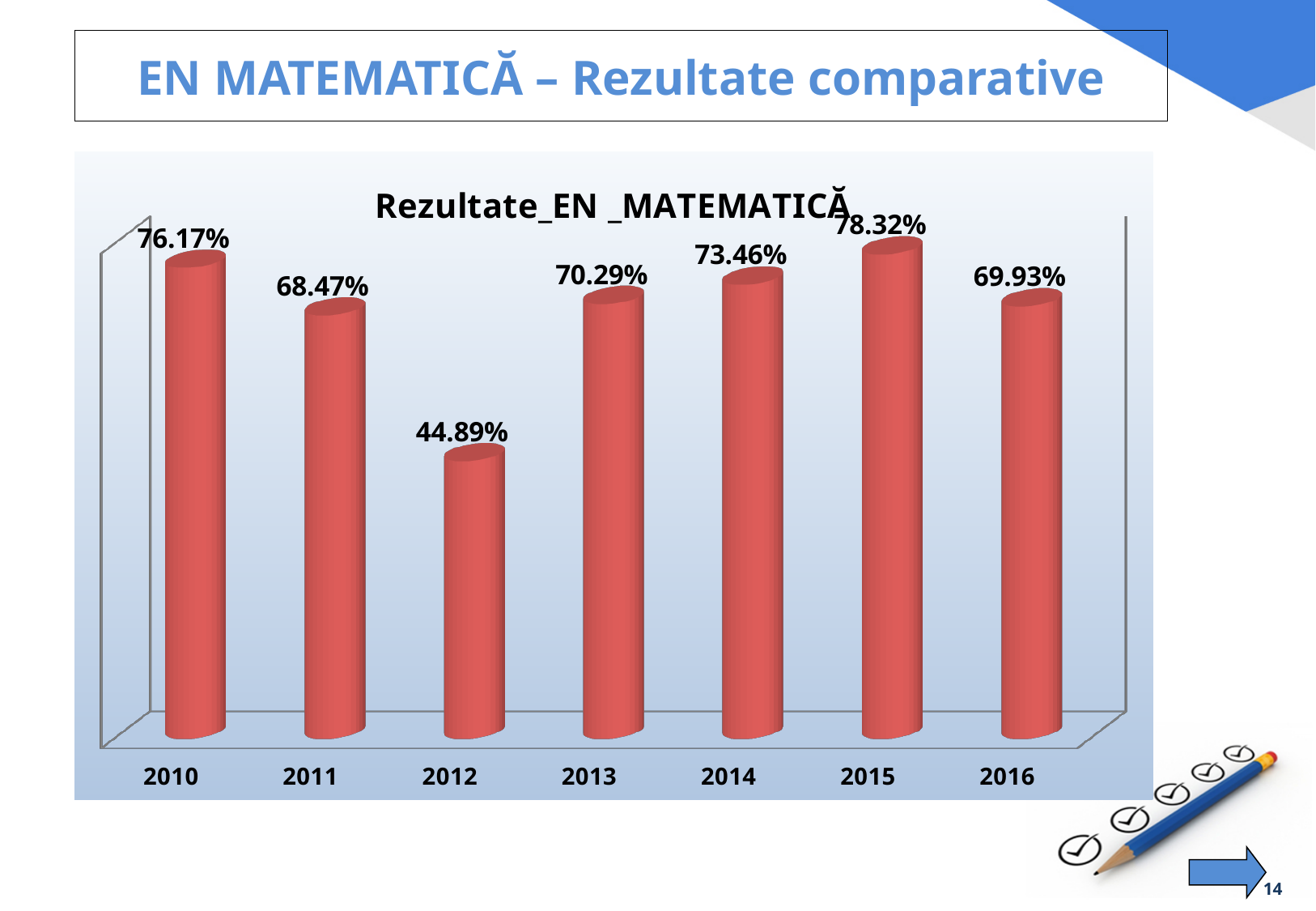
What is the value for 2010? 76.17% How many years are shown on the x axis? 7 Which is larger, the value for 2011 or the value for 2014? 2014 What kind of chart is this? Bar chart What is the value for 2015? 78.32% What is the title of the chart? Rezultate_EN _MATEMATICĂ Which year has the lowest value? 2012 What is the difference between the values for 2015 and 2012? 33.43% What is the value for 2012? 44.89% What is the value for 2016? 69.93% What is the difference between the values for 2010 and 2011? 7.70% Which year has the highest value? 2015